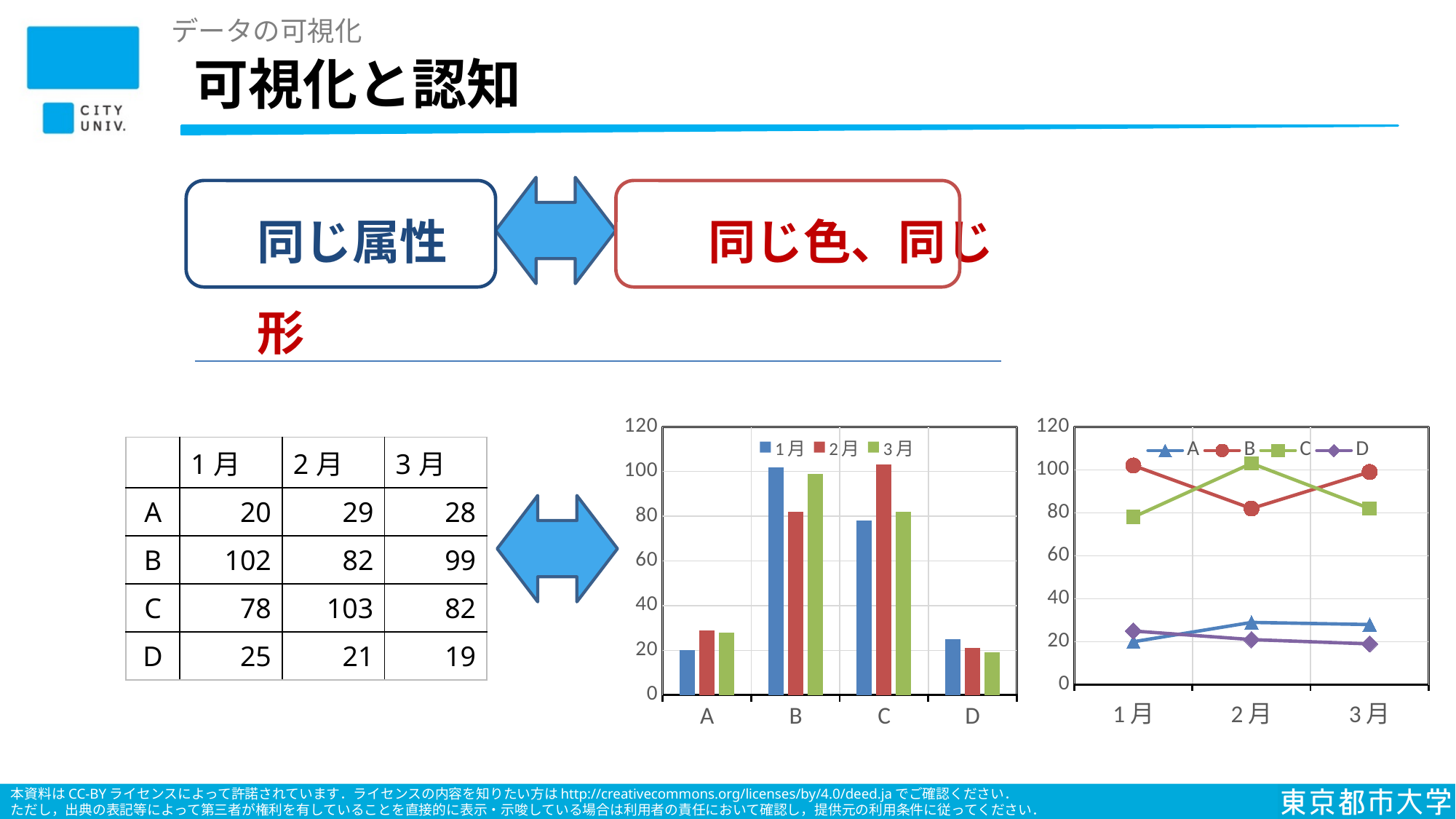
In the middle bar chart, which category has the tallest 2月 bar? C In the right-hand line chart, how many series does the legend list? 4 In the right-hand line chart, which series has the highest value at 2月? C In the middle bar chart, which category has the shortest 3月 bar? D What kind of chart is the middle chart with categories A, B, C and D? bar chart In the middle bar chart, how many categories are shown on the x axis? 4 In the middle bar chart, how many series does the legend list? 3 In the right-hand line chart, is the value for series D at 3月 greater or less than 20? less What kind of chart is the right-hand chart with 1月, 2月 and 3月 on the x axis? line chart In the right-hand line chart, does the line for series B rise or fall from 1月 to 2月? fall In the middle bar chart, is the 2月 value for A greater or less than 40? less In the middle bar chart, is the 1月 value for B greater or less than 100? greater